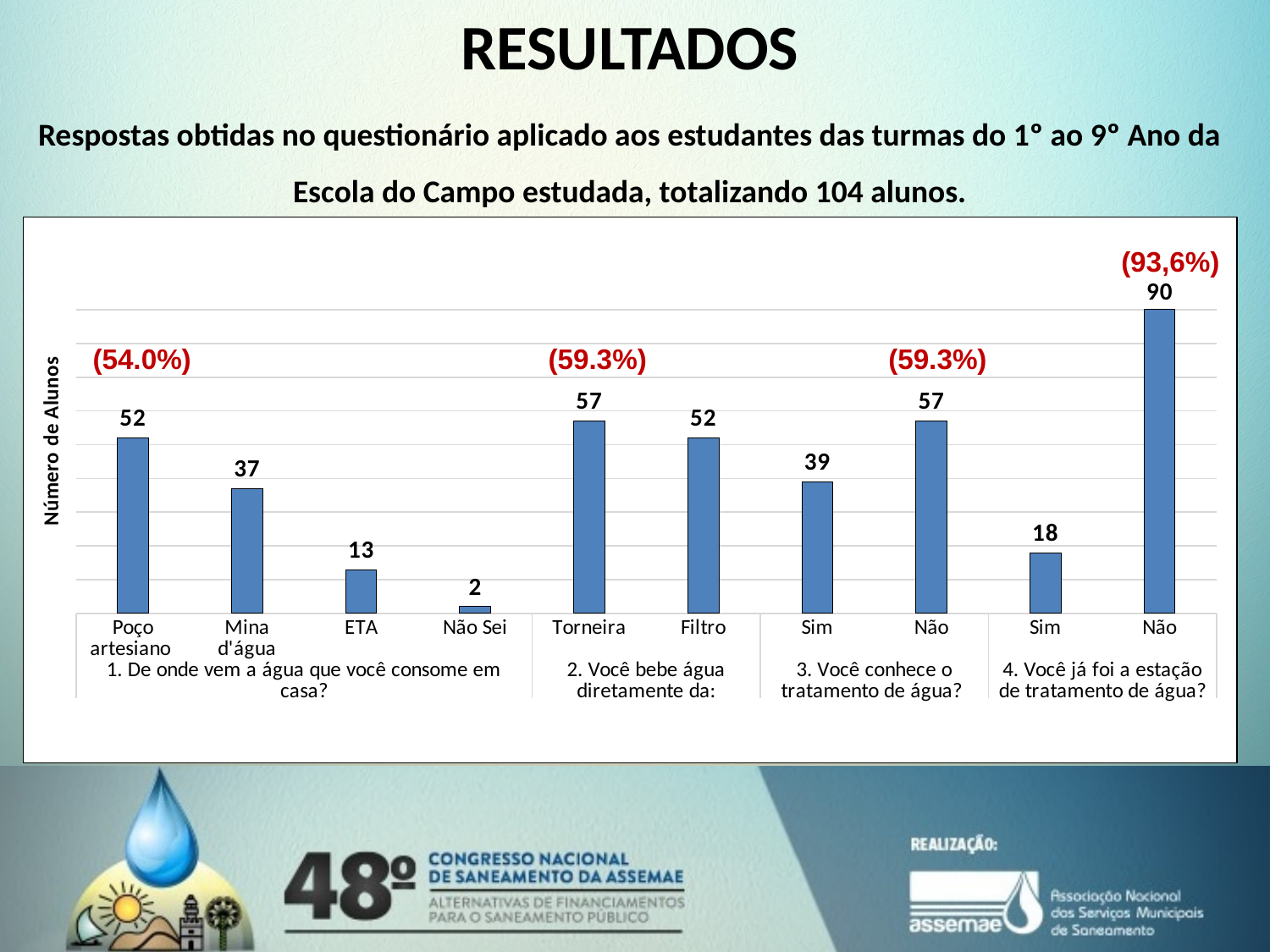
Which bar in the chart has the lowest value? Não Sei How many students answered "Não" to question 4 (Você já foi a estação de tratamento de água?)? 90 For question 2, which answer has more students: Torneira or Filtro? Torneira What percentage is shown in red above the "Não" bar for question 4? (93,6%) What is the difference between the "Não" and "Sim" answers for question 3 (Você conhece o tratamento de água?)? 18 What is the label of the vertical axis? Número de Alunos How many bars are plotted in the chart in total? 10 How many students answered "Não Sei" to question 1? 2 What kind of chart is shown on the slide? bar chart Which bar in the chart has the highest value? Não (question 4) How many students answered "Poço artesiano" to question 1 (De onde vem a água que você consome em casa?)? 52 How many students answered "Torneira" to question 2 (Você bebe água diretamente da:)? 57